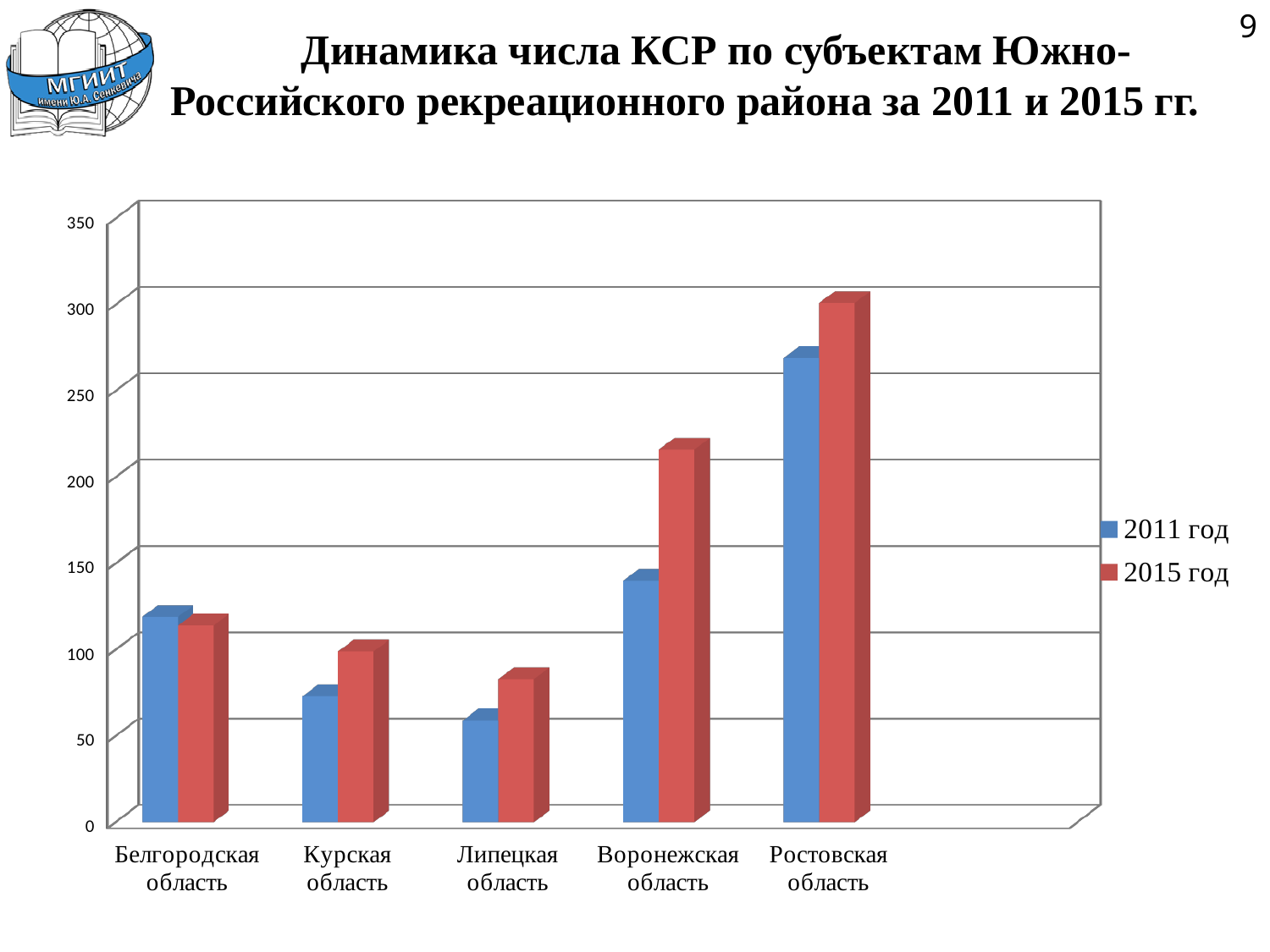
What kind of chart is shown on the slide? bar chart Is the value for Воронежская область in 2011 год greater or less than 150? less Is the value for Ростовская область in 2015 год greater or less than 250? greater Is the value for Липецкая область in 2011 год greater or less than 100? less Which region has the highest value for 2015 год? Ростовская область Which is larger: the 2011 год value for Ростовская область or the 2015 год value for Воронежская область? Ростовская область (2011 год) How many series does the chart's legend list? 2 How many regions (categories) are shown on the x axis of the chart? 5 Which region has the lowest value for 2015 год? Липецкая область For Воронежская область, which is larger: the value for 2011 год or for 2015 год? 2015 год Which region has the lowest value for 2011 год? Липецкая область What are the two entries listed in the chart's legend? 2011 год, 2015 год